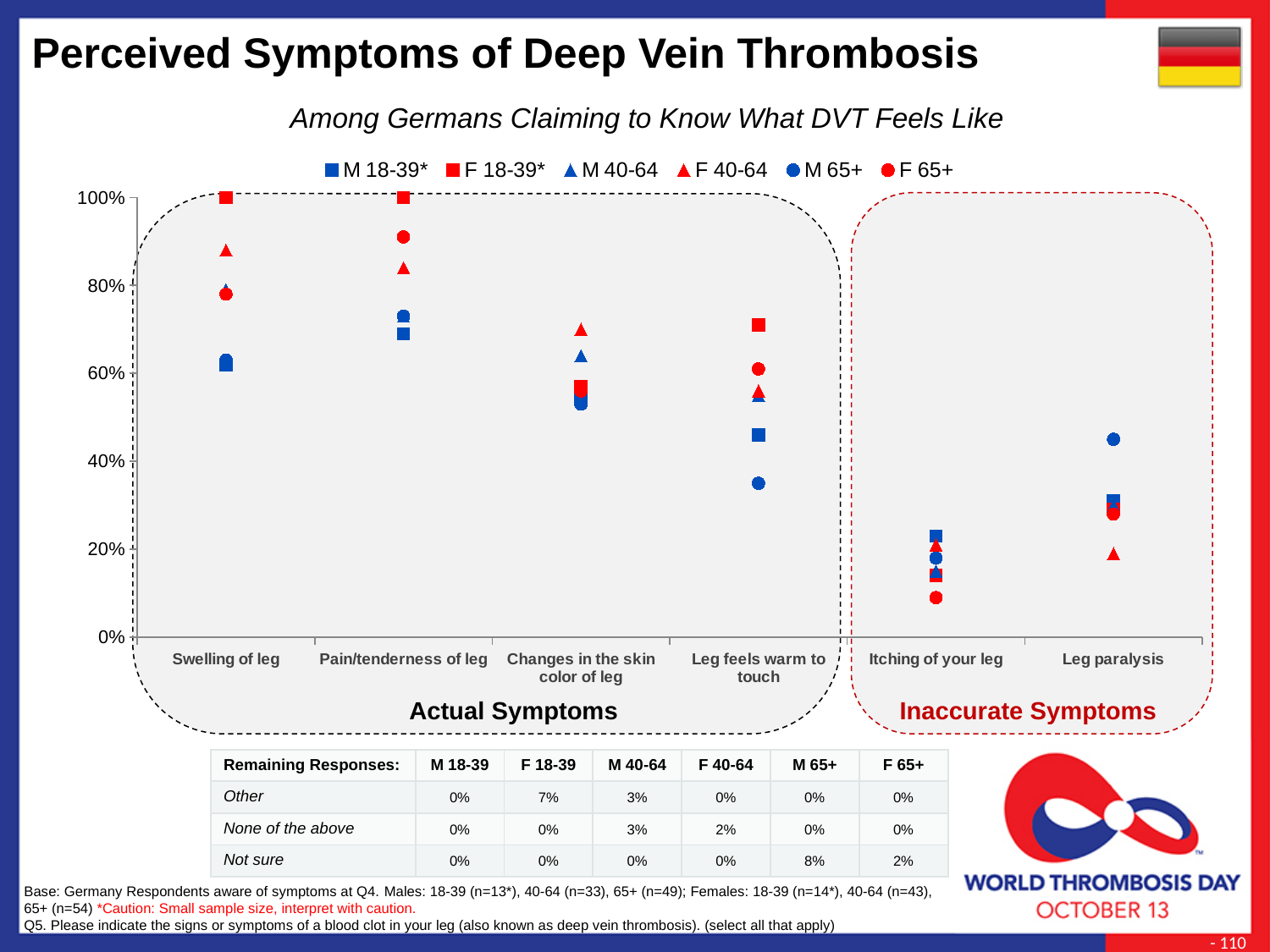
Is the value for M 65+ for Leg feels warm to touch greater or less than 40%? less What is the value for F 18-39* for Pain/tenderness of leg? 100% Is the value for F 65+ for Itching of your leg greater or less than 20%? less How many symptom categories are plotted along the x axis? 6 Which series has the highest value for Leg paralysis? M 65+ Is the value for F 65+ for Pain/tenderness of leg greater or less than 80%? greater What kind of chart is shown on the slide? scatter (dot) chart Which two categories are grouped under the label 'Inaccurate Symptoms'? Itching of your leg and Leg paralysis Which series has the highest value for Swelling of leg? F 18-39* How many series does the legend list? 6 What is the value for F 18-39* for Swelling of leg? 100% Which series has the lowest value for Leg feels warm to touch? M 65+